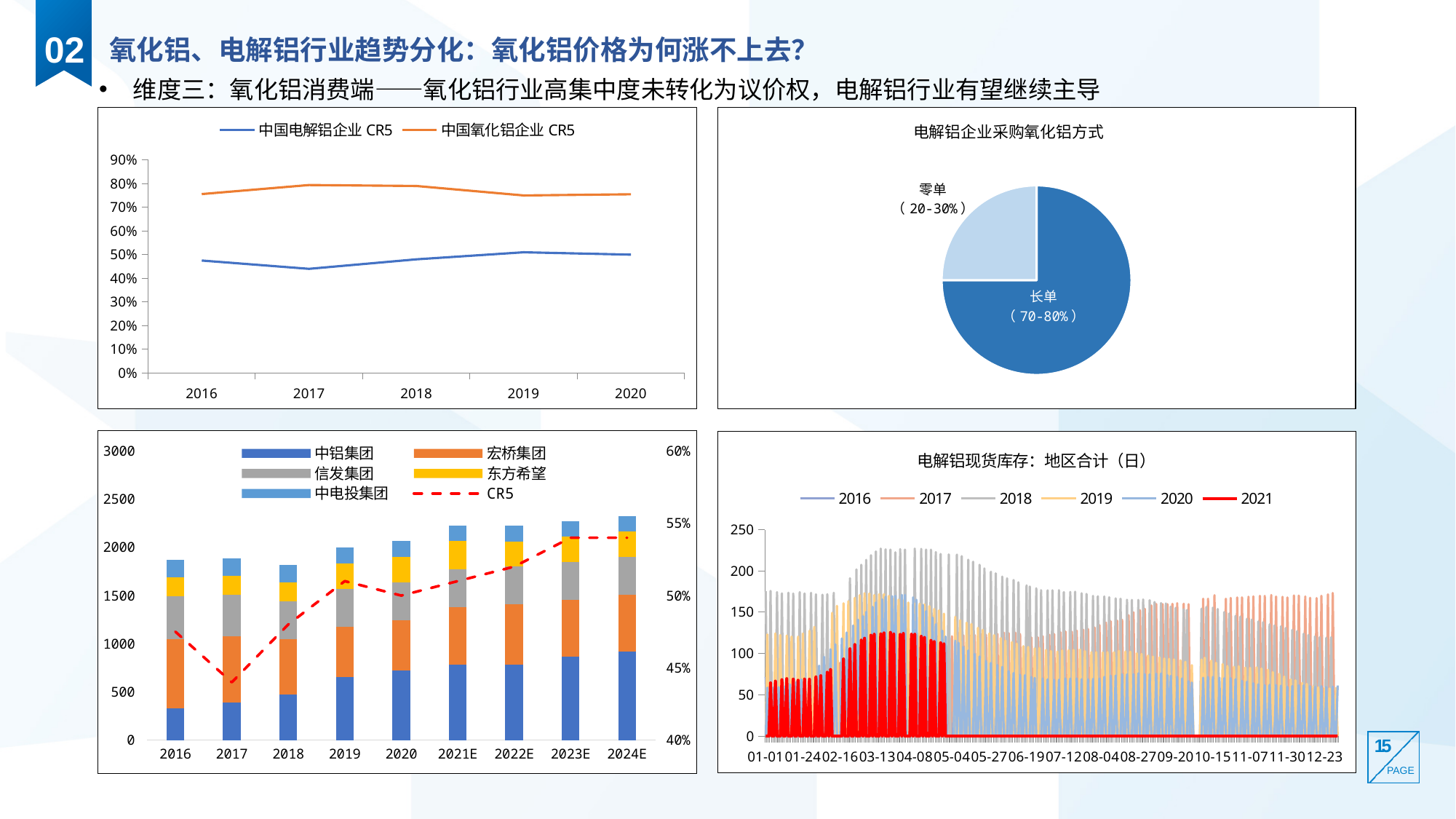
In the pie chart titled 电解铝企业采购氧化铝方式, how many slices are there? 2 In the top-left line chart, how many years are shown on the x axis? 5 In the top-left line chart, which series is higher in 2016, 中国电解铝企业 CR5 or 中国氧化铝企业 CR5? 中国氧化铝企业 CR5 In the top-left line chart, is the value for 中国氧化铝企业 CR5 in 2018 greater or less than 70%? greater In the chart titled 电解铝现货库存：地区合计（日）, how many series does the legend list? 6 In the top-left line chart, how many series does the legend list? 2 In the pie chart titled 电解铝企业采购氧化铝方式, which slice is larger, 零单 or 长单? 长单 In the top-left line chart, is the value for 中国电解铝企业 CR5 in 2017 greater or less than 50%? less In the bottom-left stacked bar chart, how many entries does the legend list? 6 In the bottom-left stacked bar chart, how many categories are shown on the x axis? 9 In the pie chart titled 电解铝企业采购氧化铝方式, what share range is labelled for 零单? 20-30% In the bottom-left stacked bar chart, is the CR5 value in 2017 greater or less than 45%? less